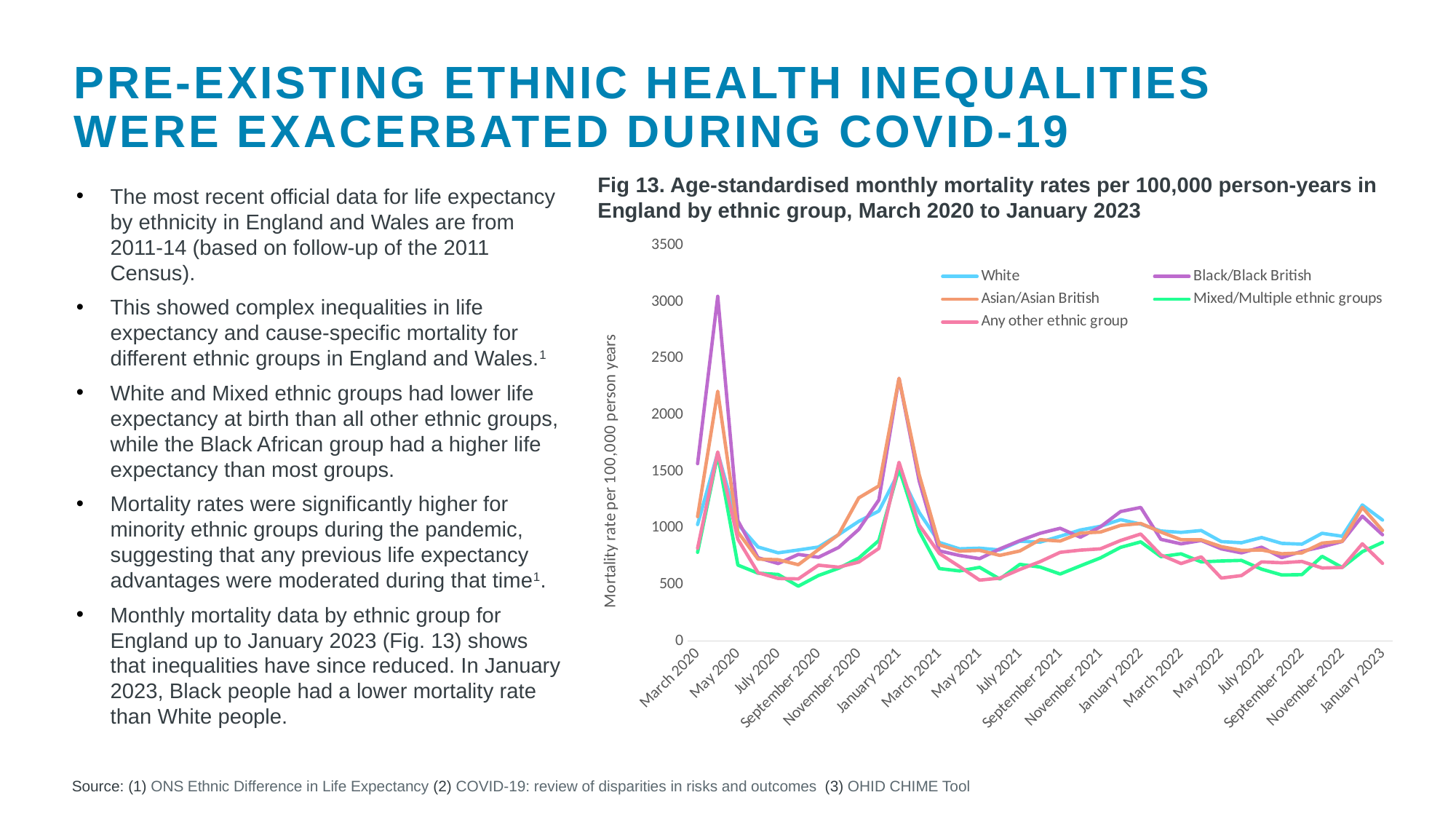
Is the January 2021 peak value for Asian/Asian British greater or less than 2000? greater In January 2023, which group has the higher mortality rate, White or Black/Black British? White How many month labels are shown on the x axis of Fig 13? 18 Is the April 2020 peak value for Black/Black British greater or less than 2500? greater Which ethnic group reaches the highest mortality rate at the April 2020 peak in Fig 13? Black/Black British What is the label on the y axis of Fig 13? Mortality rate per 100,000 person years Do the mortality rates rise or fall between January 2021 and March 2021? fall Which ethnic group has the lowest mortality rate in January 2023? Any other ethnic group At the April 2020 peak, which is higher, Asian/Asian British or White? Asian/Asian British How many ethnic groups (series) does the legend of Fig 13 list? 5 Is the January 2021 value for Mixed/Multiple ethnic groups greater or less than 1000? greater What kind of chart is Fig 13? line chart